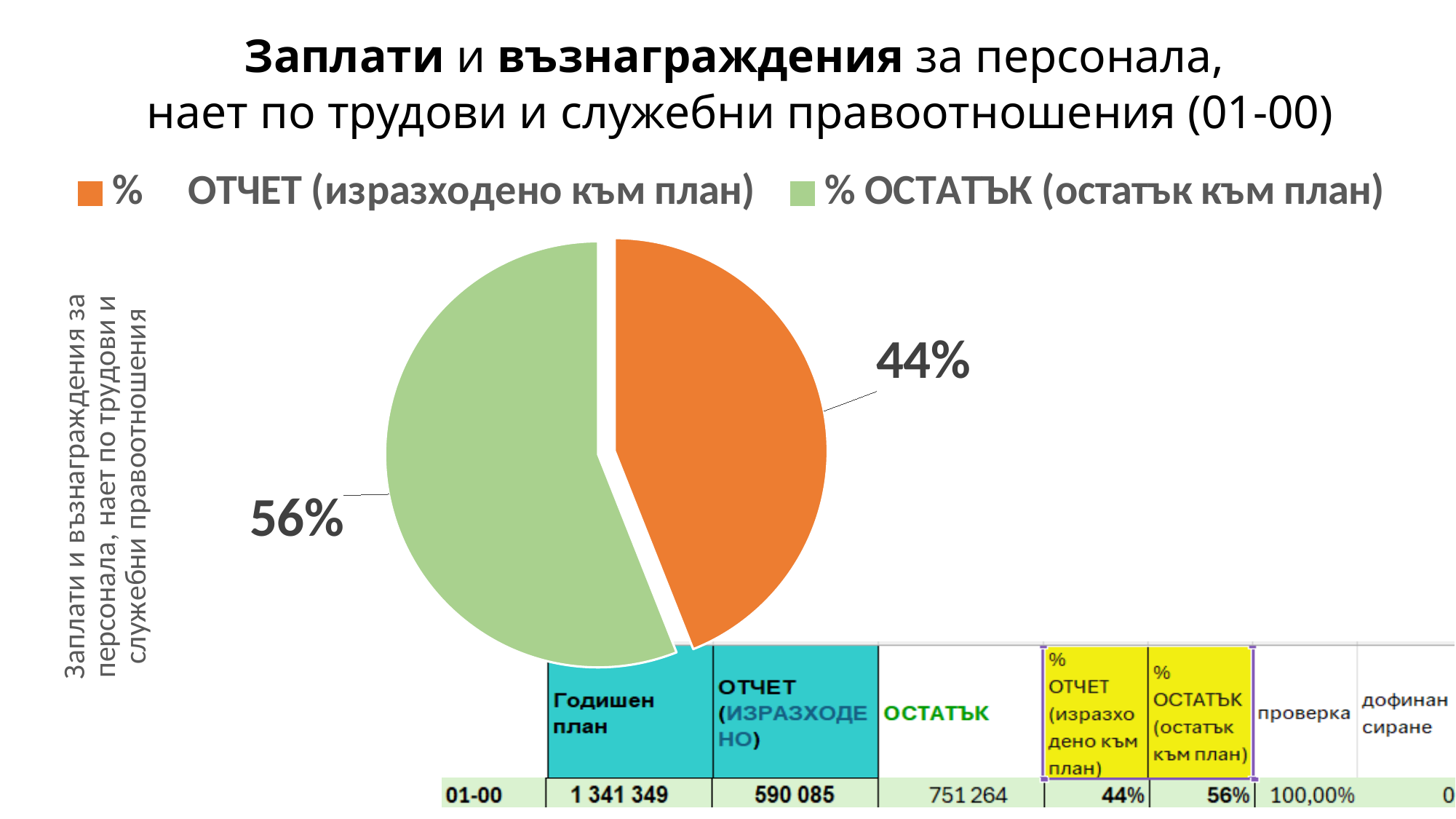
What colour is the slice for "% ОСТАТЪК (остатък към план)"? green What colour is the slice for "% ОТЧЕТ (изразходено към план)"? orange What percentage does the slice for "% ОТЧЕТ (изразходено към план)" show? 44% What percentage does the slice for "% ОСТАТЪК (остатък към план)" show? 56% How many entries does the legend list? 2 What share of the pie does the green slice represent? 56% Which slice of the pie is the smallest? % ОТЧЕТ (изразходено към план) How many slices does the pie chart have? 2 What is the difference in percentage points between the ОСТАТЪК slice and the ОТЧЕТ slice? 12 Which slice of the pie is the largest? % ОСТАТЪК (остатък към план) What kind of chart is shown on the slide? pie chart Which is larger: the ОТЧЕТ slice or the ОСТАТЪК slice? ОСТАТЪК